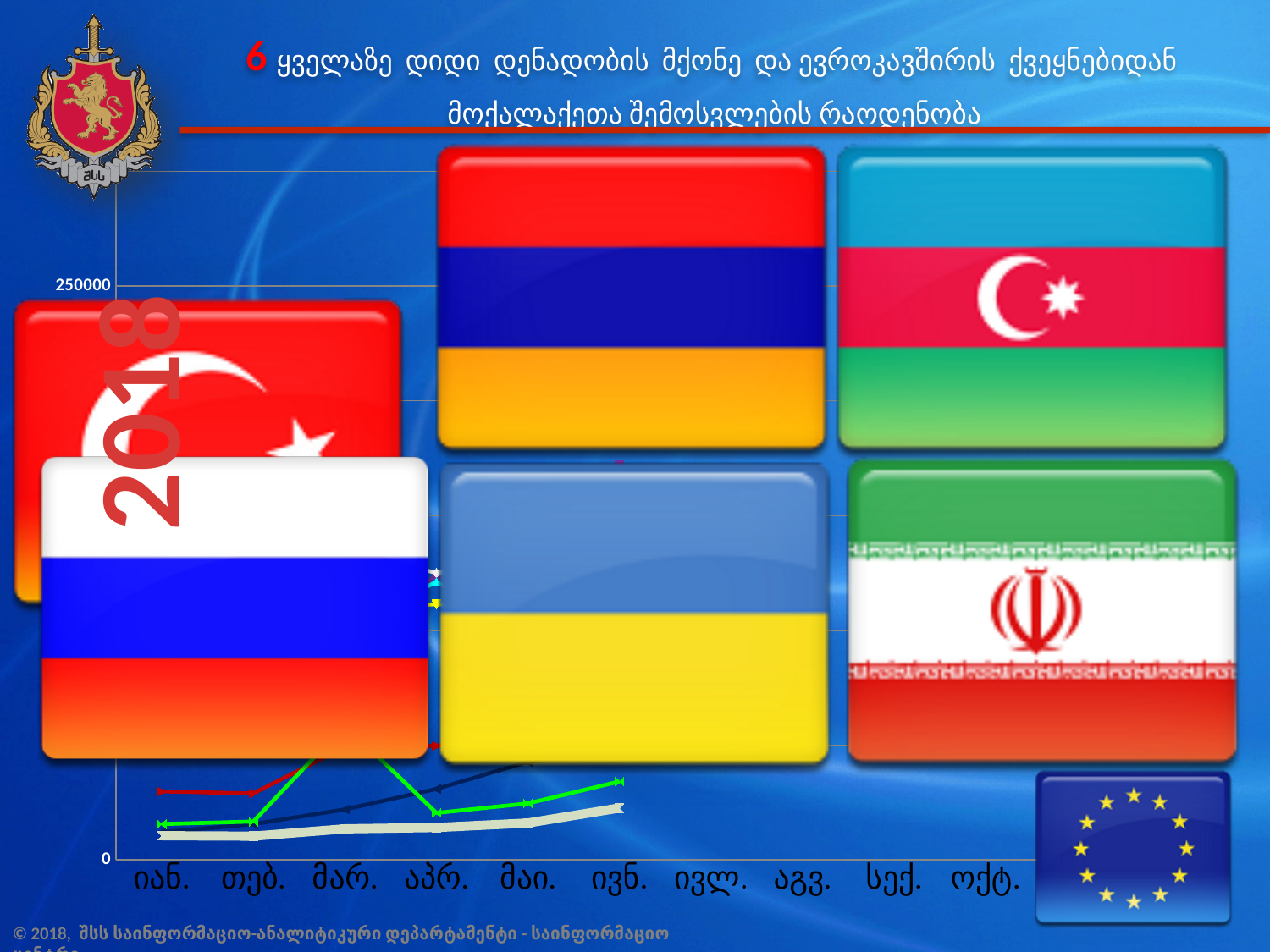
Is the value of the green line in იან. greater or less than 250000? less What is the highest value shown on the y axis of the chart? 250000 What is the last month label on the x axis of the chart? ოქტ. Is the value of the red line in თებ. greater or less than 250000? less What is the first month label on the x axis of the chart? იან. What kind of chart is shown on the slide? line chart How many months are labelled along the x axis of the chart? 10